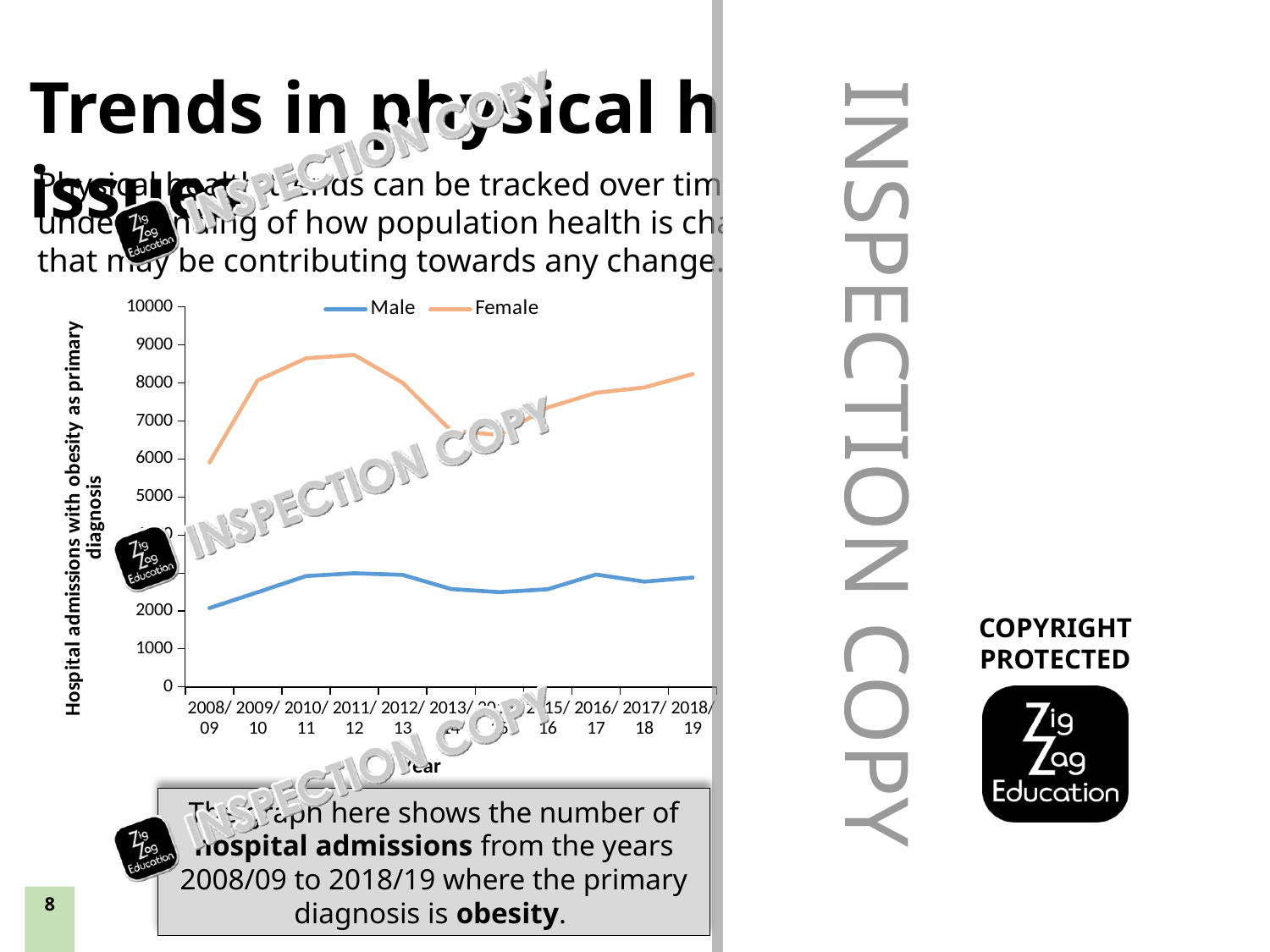
What is the title of the chart's y axis? Hospital admissions with obesity as primary diagnosis How many years are plotted along the x axis of the chart? 11 Which year has the lowest value for the Male series? 2008/09 What kind of chart is shown on the slide? Line chart Is the Male value for 2008/09 greater or less than 3000? less Is the Male value for 2011/12 greater or less than 2000? greater Is the Female value for 2009/10 greater or less than 7000? greater Does the Female series rise or fall from 2008/09 to 2011/12? Rise In 2008/09, which series has the larger value, Male or Female? Female Which year has the lowest value for the Female series? 2008/09 How many series does the chart's legend list? 2